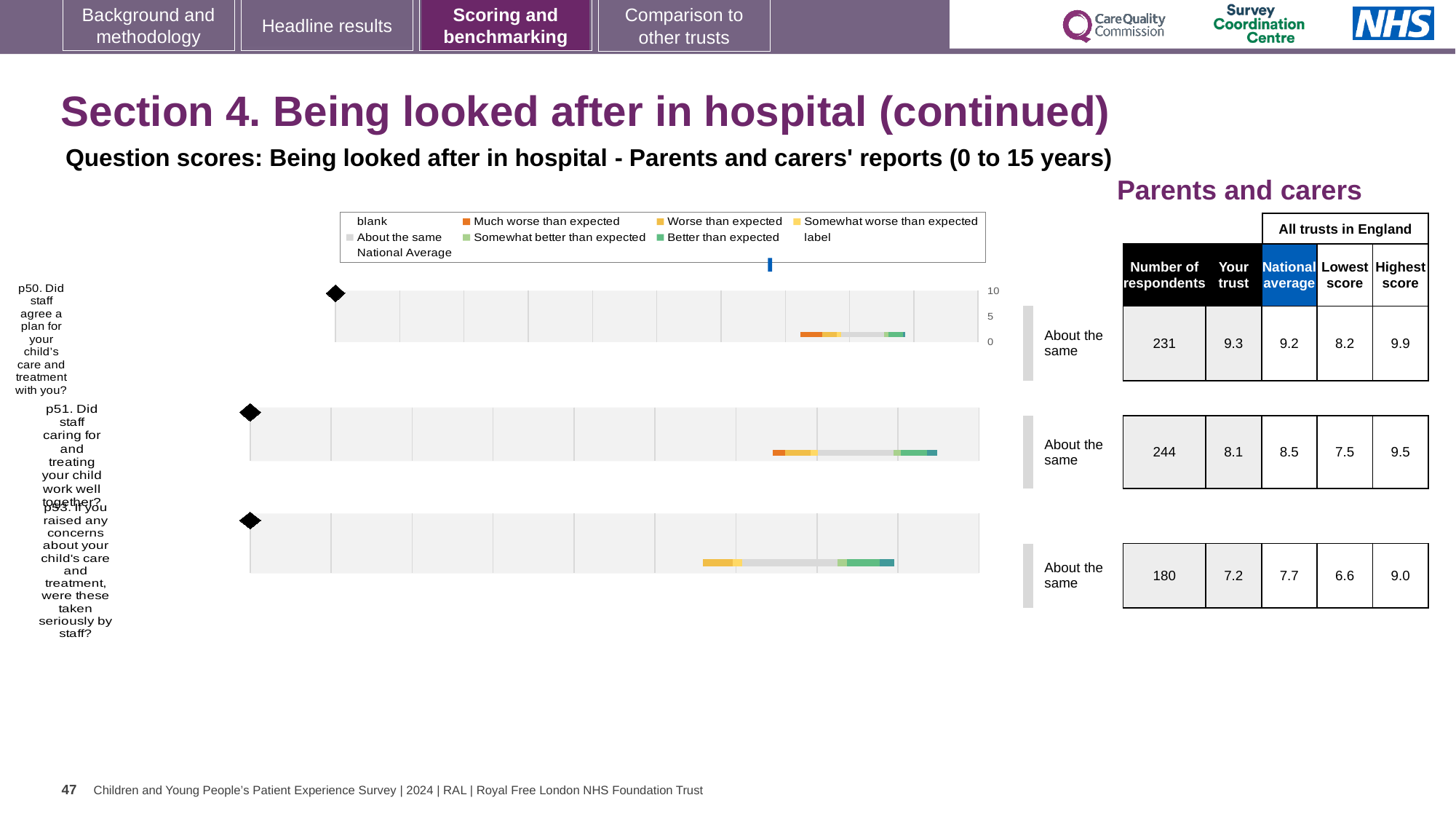
How many survey questions are plotted in the benchmarking charts on this slide? 3 What is the lowest score across all trusts in England for question p53? 6.6 Which colour in the legend represents 'Much worse than expected'? Orange What benchmarking category is shown for each of the three questions on this slide? About the same Which question has the highest 'Your trust' score? p50 Which question has the lowest 'Your trust' score? p53 What kind of chart is used to show the benchmarking results for each question? Bar chart For question p51, which is larger: the 'Your trust' score or the national average? National average How many respondents answered question p53 (If you raised any concerns about your child's care and treatment, were these taken seriously by staff?)? 180 What is the national average score for question p51 (Did staff caring for and treating your child work well together?)? 8.5 What is the 'Your trust' score for question p50 (Did staff agree a plan for your child's care and treatment with you?)? 9.3 What is the difference between the highest score and the lowest score across all trusts in England for question p50? 1.7